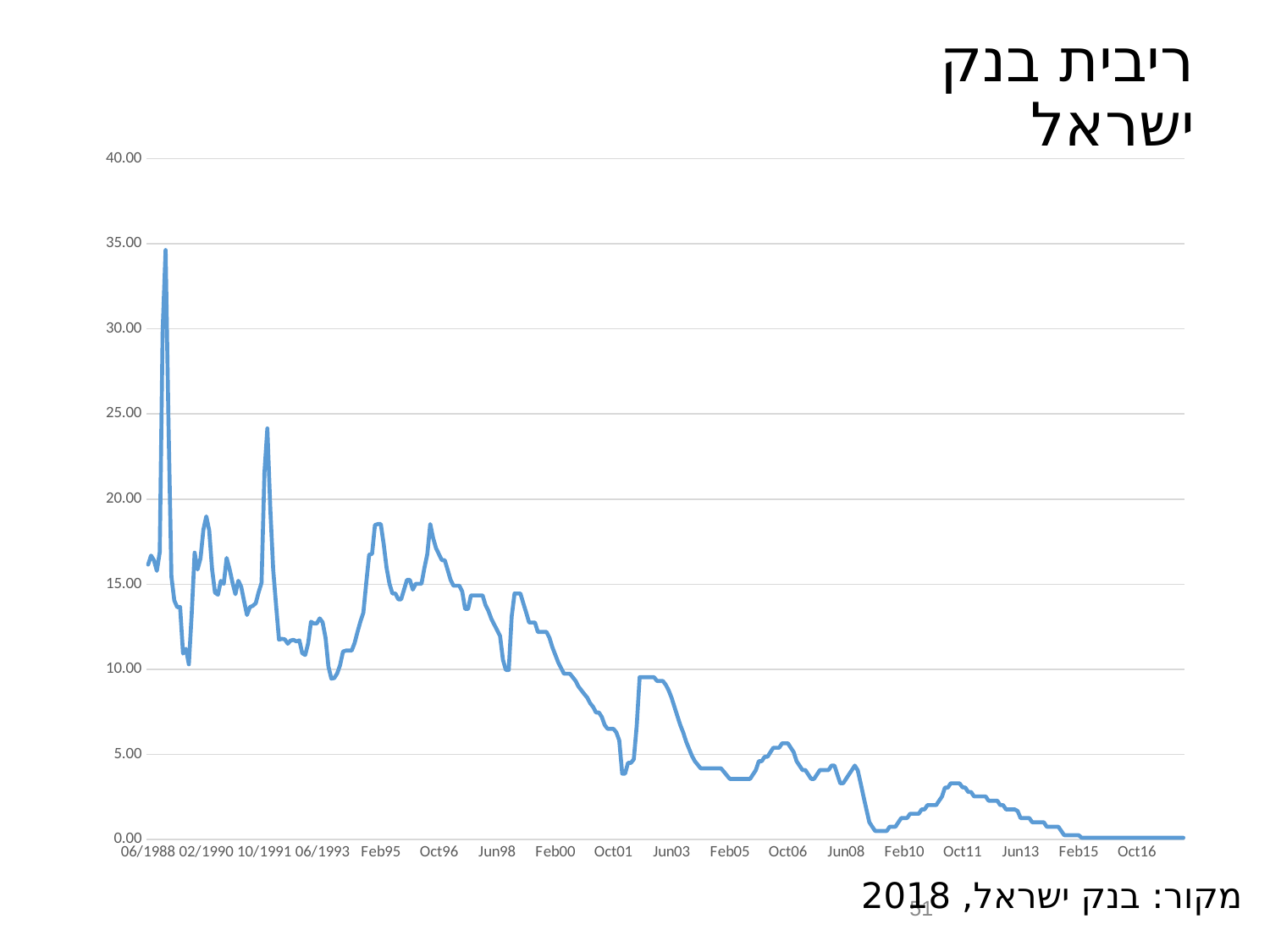
Is the highest point on the line greater or less than 30.00? greater Is the value at Feb10 greater or less than 5.00? less How many date labels are shown on the x axis? 18 Is the value at Jun03 greater or less than 5.00? greater What kind of chart is shown on the slide? line chart What is the first date label on the x axis? 06/1988 Which is larger, the value at Oct96 or the value at Oct16? Oct96 Overall, do the values rise or fall from 06/1988 to Oct16? fall What is the highest value shown on the y axis? 40.00